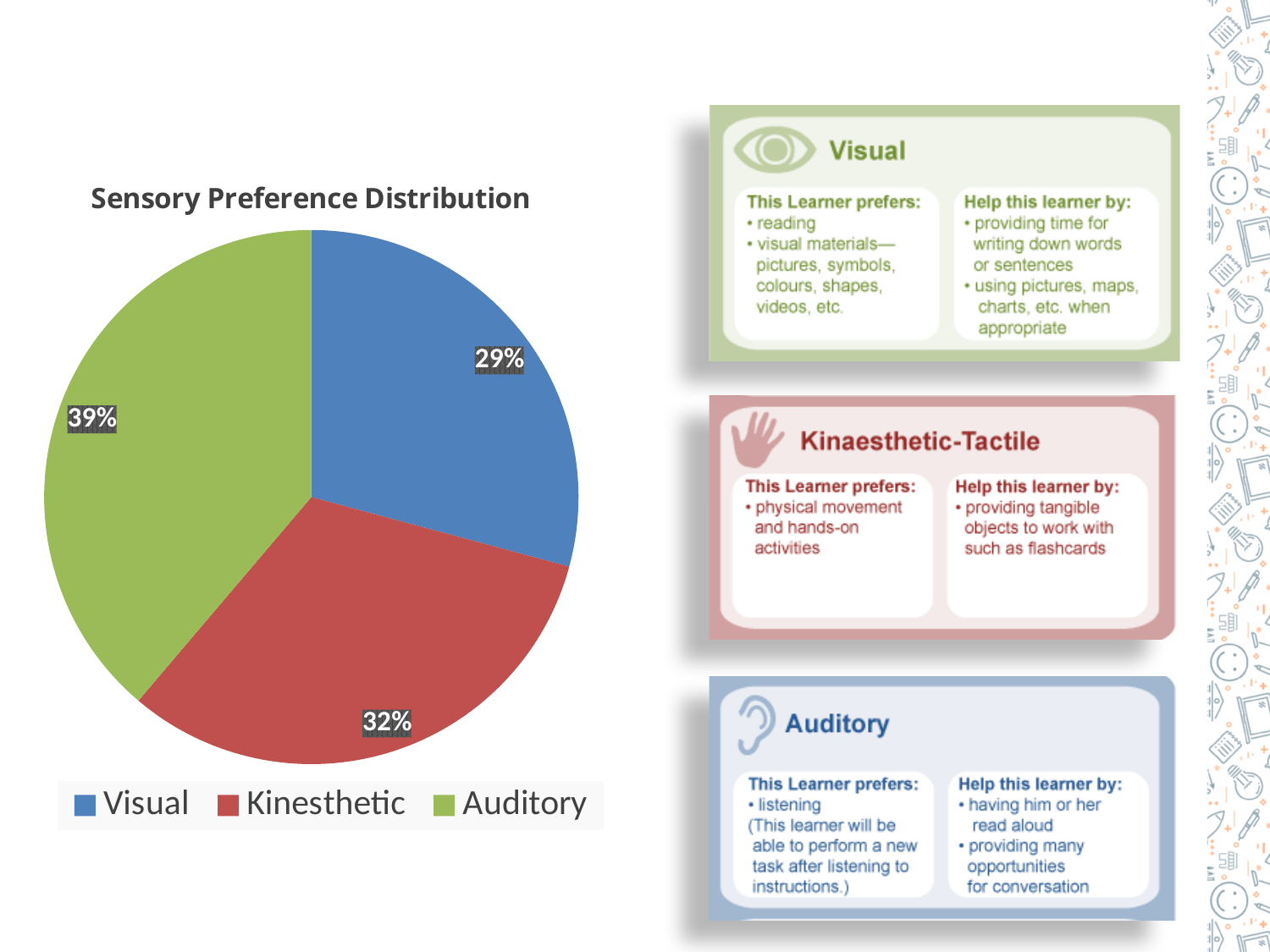
What is the difference in percentage points between Auditory and Visual in the pie chart? 10 How many categories does the pie chart show? 3 Which category has the smallest share of the pie chart? Visual How many entries does the legend of the pie chart list? 3 What is the title of the pie chart? Sensory Preference Distribution What colour represents Kinesthetic in the pie chart? red What percentage of the pie chart is Visual? 29% What percentage of the pie chart is Auditory? 39% What percentage of the pie chart is Kinesthetic? 32% Which is larger in the pie chart, Kinesthetic or Visual? Kinesthetic Which category has the largest share of the pie chart? Auditory What type of chart is shown on the slide? pie chart